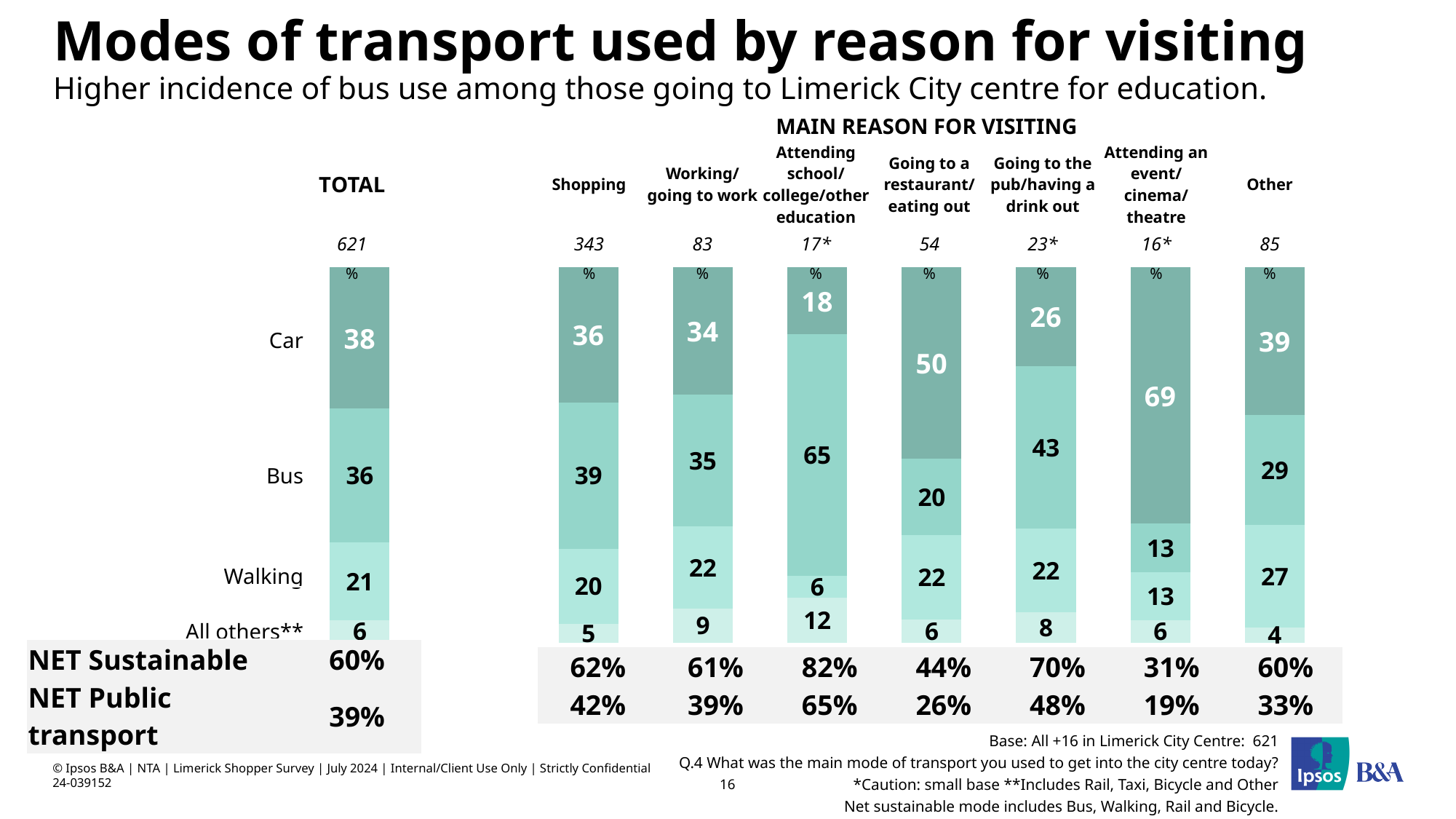
How many transport mode segments are stacked in each bar? 4 What kind of chart is used on this slide? Stacked bar chart Which reason for visiting has the lowest bus value? Attending an event/cinema/theatre For the Shopping group, which is larger: the car value or the bus value? Bus How many main reasons for visiting are shown, excluding TOTAL? 7 What is the NET Sustainable figure for those going to the pub/having a drink out? 70% What is the base size shown for the Shopping group? 343 Which reason for visiting has the highest car value? Attending an event/cinema/theatre What percentage of those attending an event/cinema/theatre used a car? 69 What is the walking value for the Other reason group? 27 For those going to a restaurant/eating out, how much higher is the car value than the bus value? 30 What is the bus value for those attending school/college/other education? 65